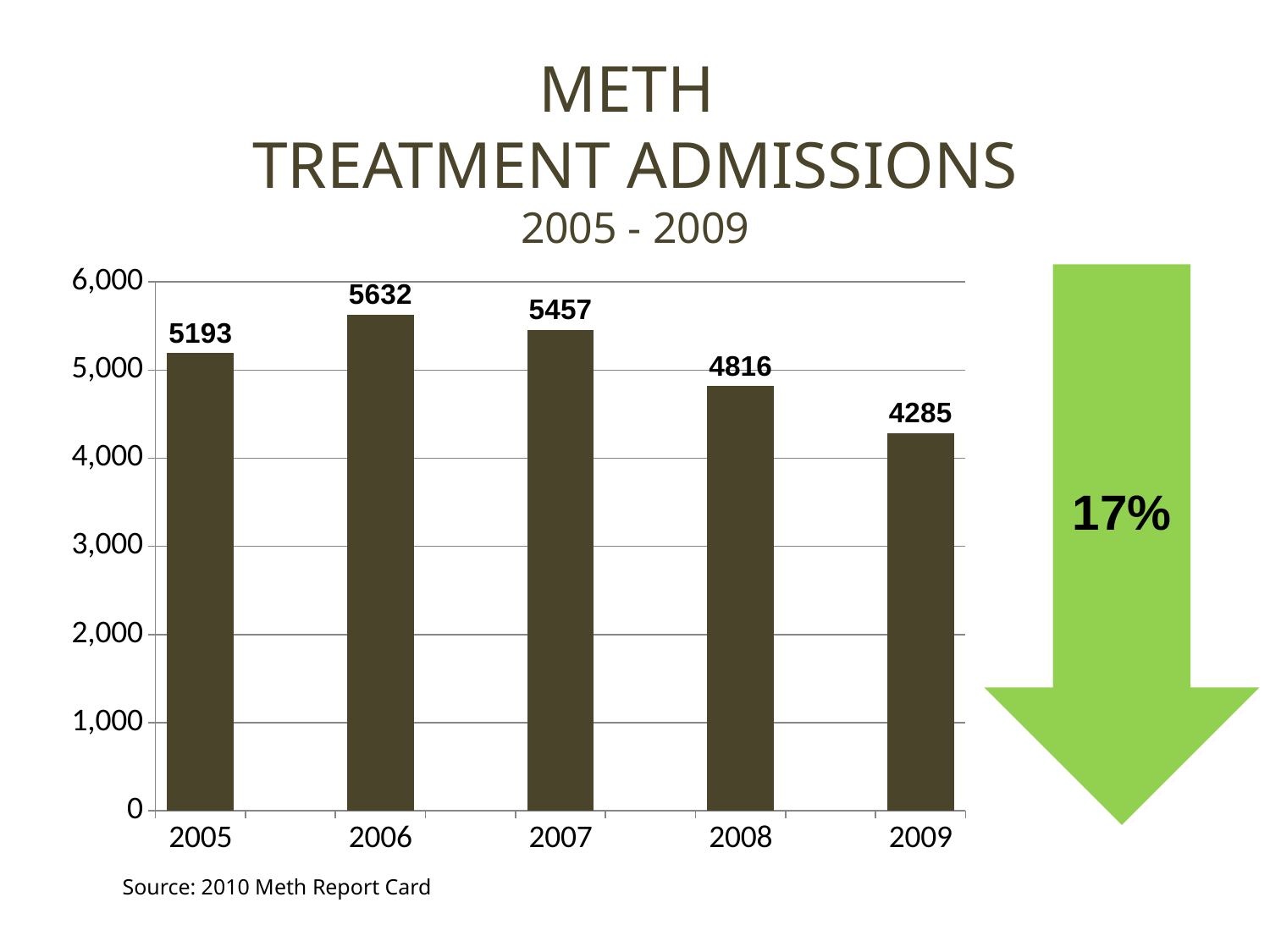
What percentage is shown in the green arrow next to the chart? 17% Which year has the lowest value? 2009 What is the value for 2007? 5457 What is the value for 2009? 4285 How many years are shown on the x axis? 5 What is the value for 2005? 5193 Is the value for 2008 greater or less than 5,000? less What is the difference between the values for 2006 and 2009? 1347 Which year has the highest value? 2006 Which is larger, the value for 2005 or the value for 2008? 2005 Do the values rise or fall from 2006 to 2009? fall What kind of chart is shown on the slide? bar chart